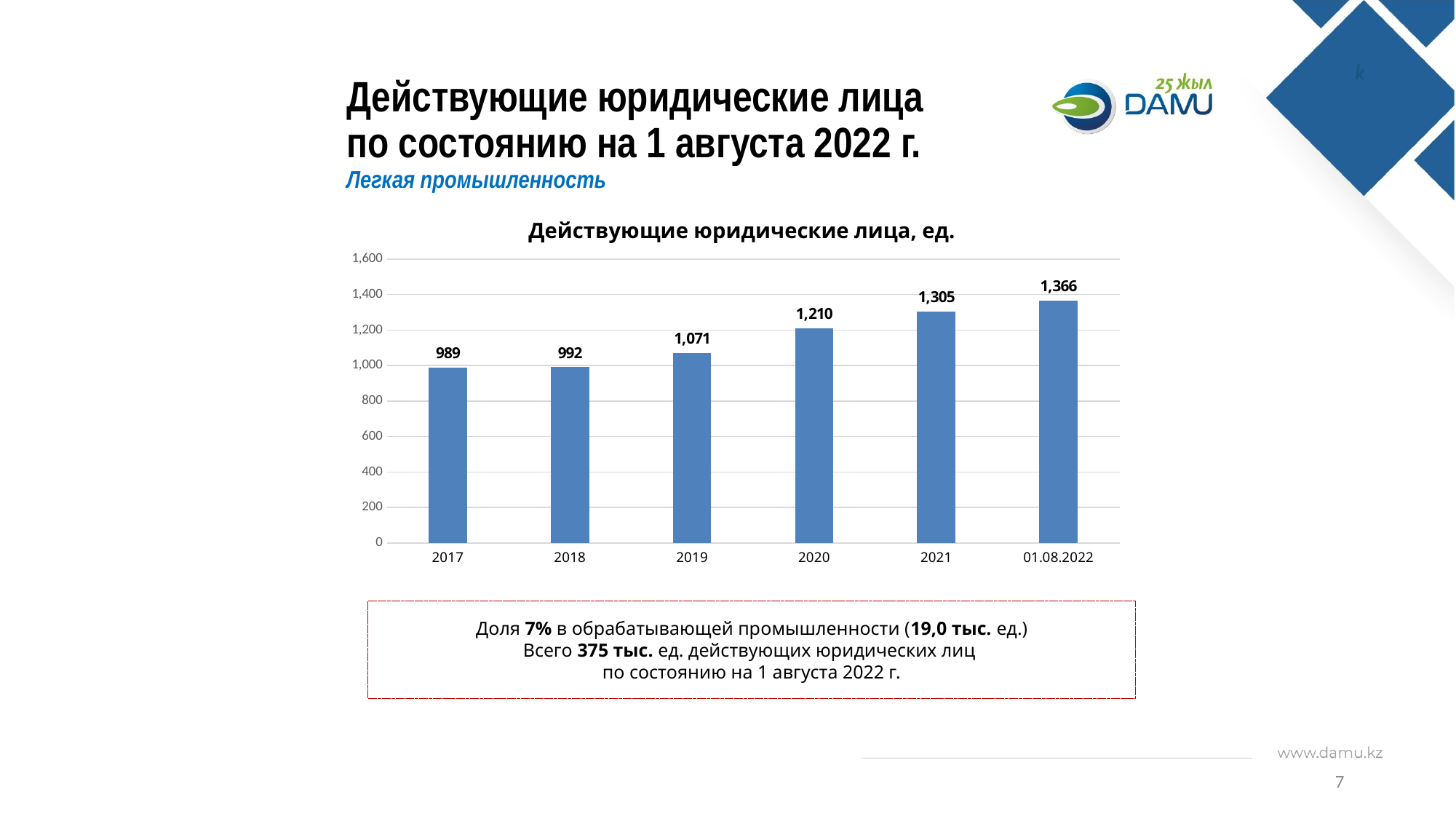
Which is larger, the value for 2019 or the value for 2018? 2019 What is the value for 2017? 989 Which category has the highest value? 01.08.2022 Do the values rise or fall from 2017 to 01.08.2022? rise How many categories are shown on the x axis? 6 What is the value for 01.08.2022? 1,366 What is the difference between the values for 01.08.2022 and 2017? 377 Which category has the lowest value? 2017 Is the value for 2021 greater or less than 1,200? greater What kind of chart is shown on the slide? bar chart What is the value for 2020? 1,210 What is the difference between the values for 2021 and 2020? 95